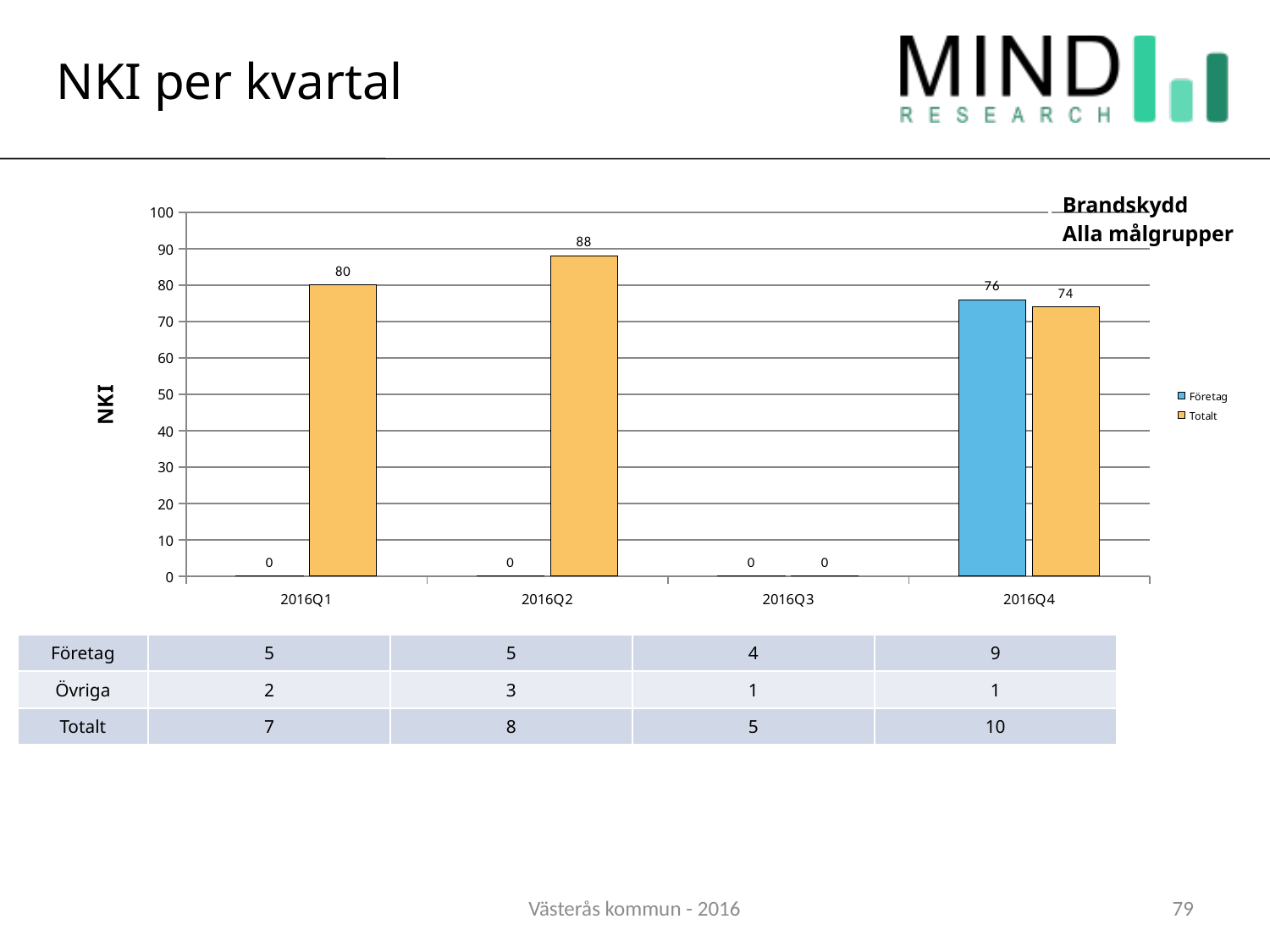
What is the Totalt value for 2016Q1? 80 How many quarters are shown on the x axis of the chart? 4 What is the label on the y axis of the chart? NKI What is the Totalt value for 2016Q4? 74 What is the Företag value for 2016Q3? 0 What type of chart is shown on the slide? bar chart Which quarter has the highest Totalt value? 2016Q2 What is the difference between the Totalt values for 2016Q2 and 2016Q1? 8 What is the Företag value for 2016Q4? 76 In 2016Q4, which is larger, the Företag value or the Totalt value? Företag What is the Totalt value for 2016Q2? 88 How many series does the chart legend list? 2